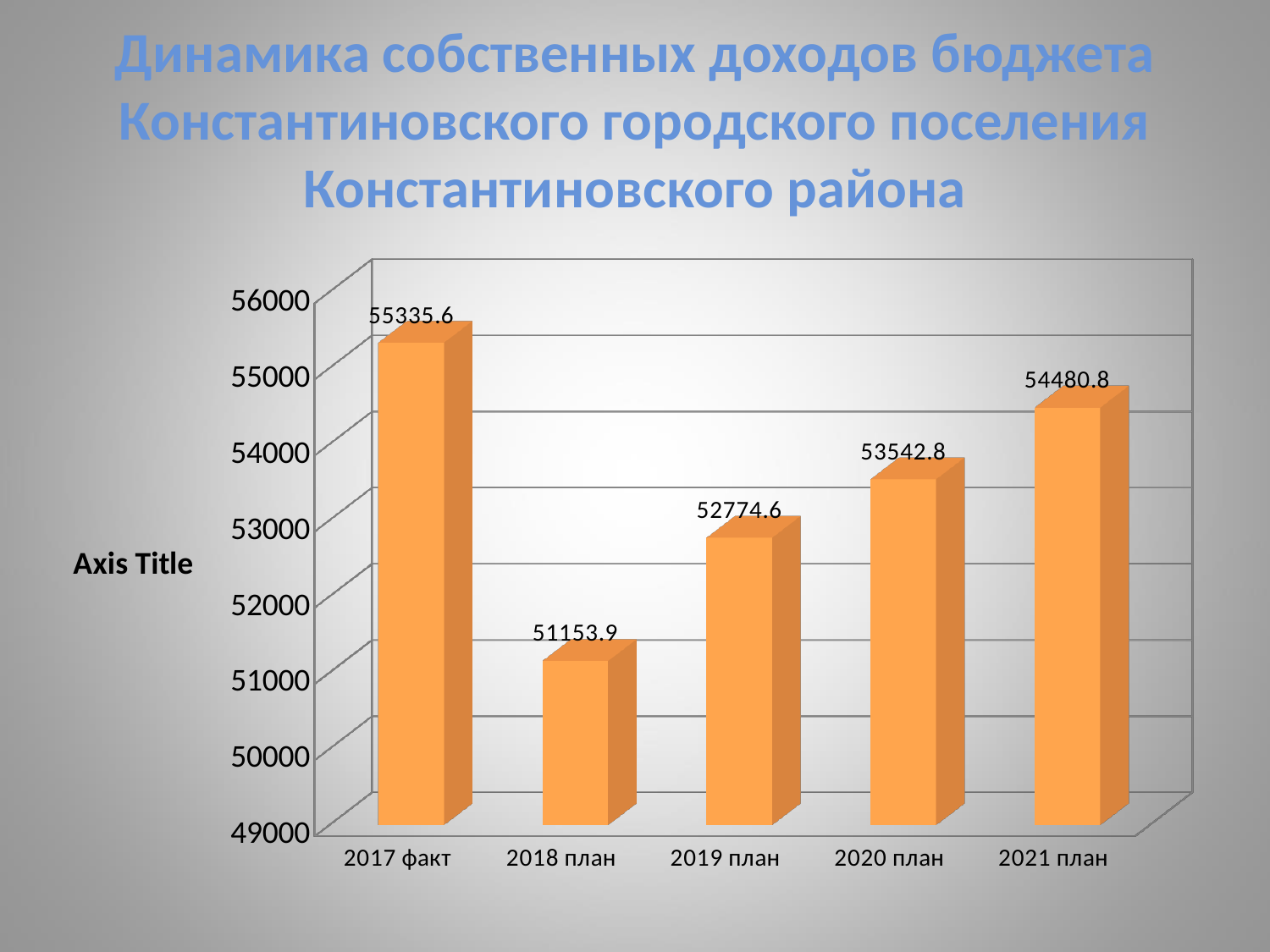
Which category has the lowest value? 2018 план What is the value for 2018 план? 51153.9 What is the value for 2021 план? 54480.8 How many categories are shown on the x axis? 5 Which is larger, the value for 2019 план or the value for 2020 план? 2020 план What kind of chart is shown on the slide? bar chart What is the difference between the values for 2017 факт and 2018 план? 4181.7 What is the value for 2020 план? 53542.8 What is the difference between the values for 2021 план and 2020 план? 938.0 Which category has the highest value? 2017 факт What is the value for 2017 факт? 55335.6 Is the value for 2019 план greater or less than 52000? greater